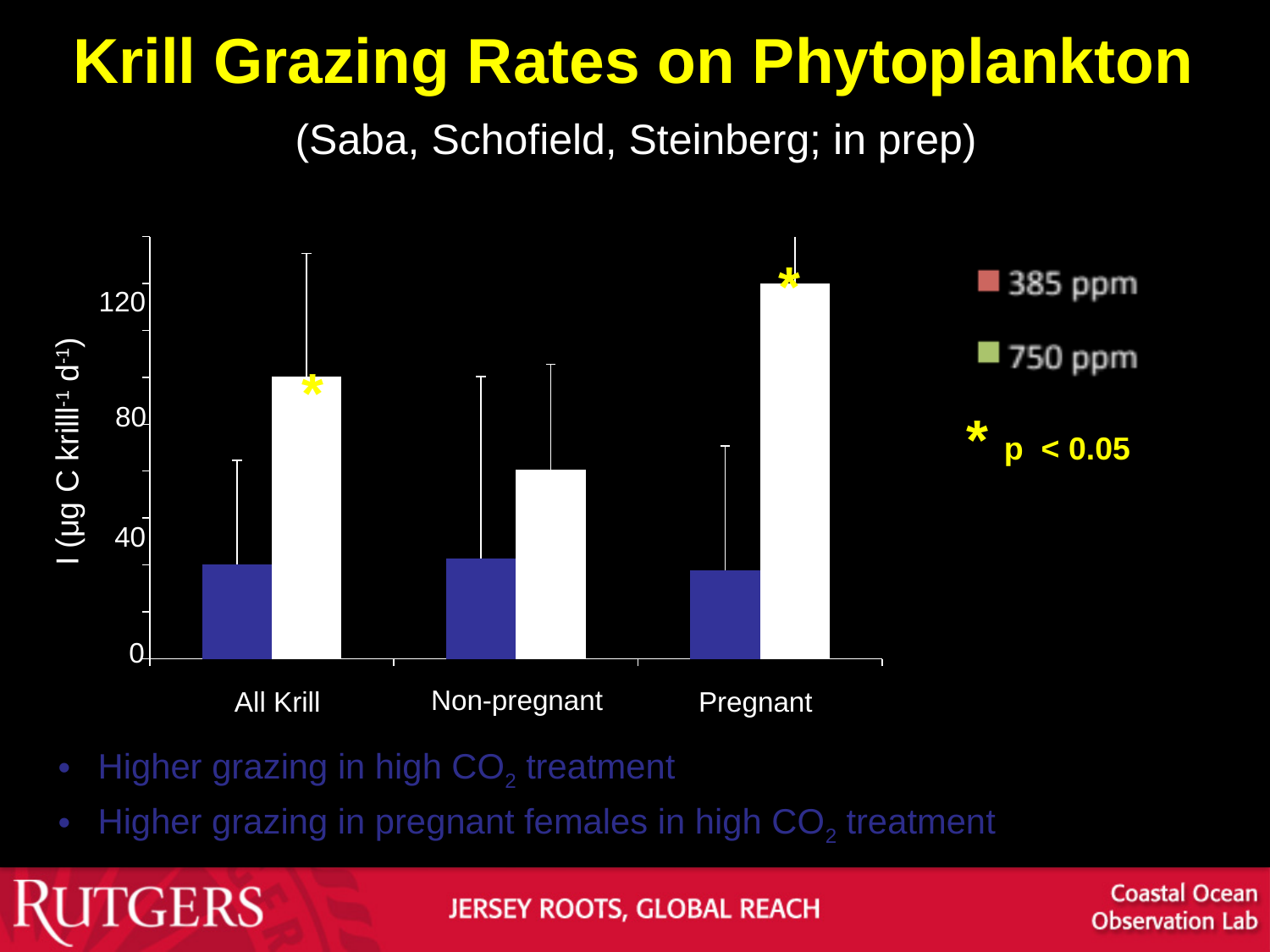
Is the 750 ppm value for Non-pregnant greater or less than 80? less Is the 750 ppm value for All Krill greater or less than 80? greater Is the 750 ppm value for Pregnant greater or less than 120? greater Which category has the lowest 750 ppm bar? Non-pregnant What are the two entries listed in the chart's legend? 385 ppm and 750 ppm How many categories are shown on the x axis of the chart? 3 Which is larger: the 750 ppm value for Pregnant or the 750 ppm value for All Krill? Pregnant For the Pregnant category, which series has the larger value, 385 ppm or 750 ppm? 750 ppm How many series does the chart's legend list? 2 What kind of chart is shown on the slide? bar chart Which category has the highest 750 ppm bar? Pregnant